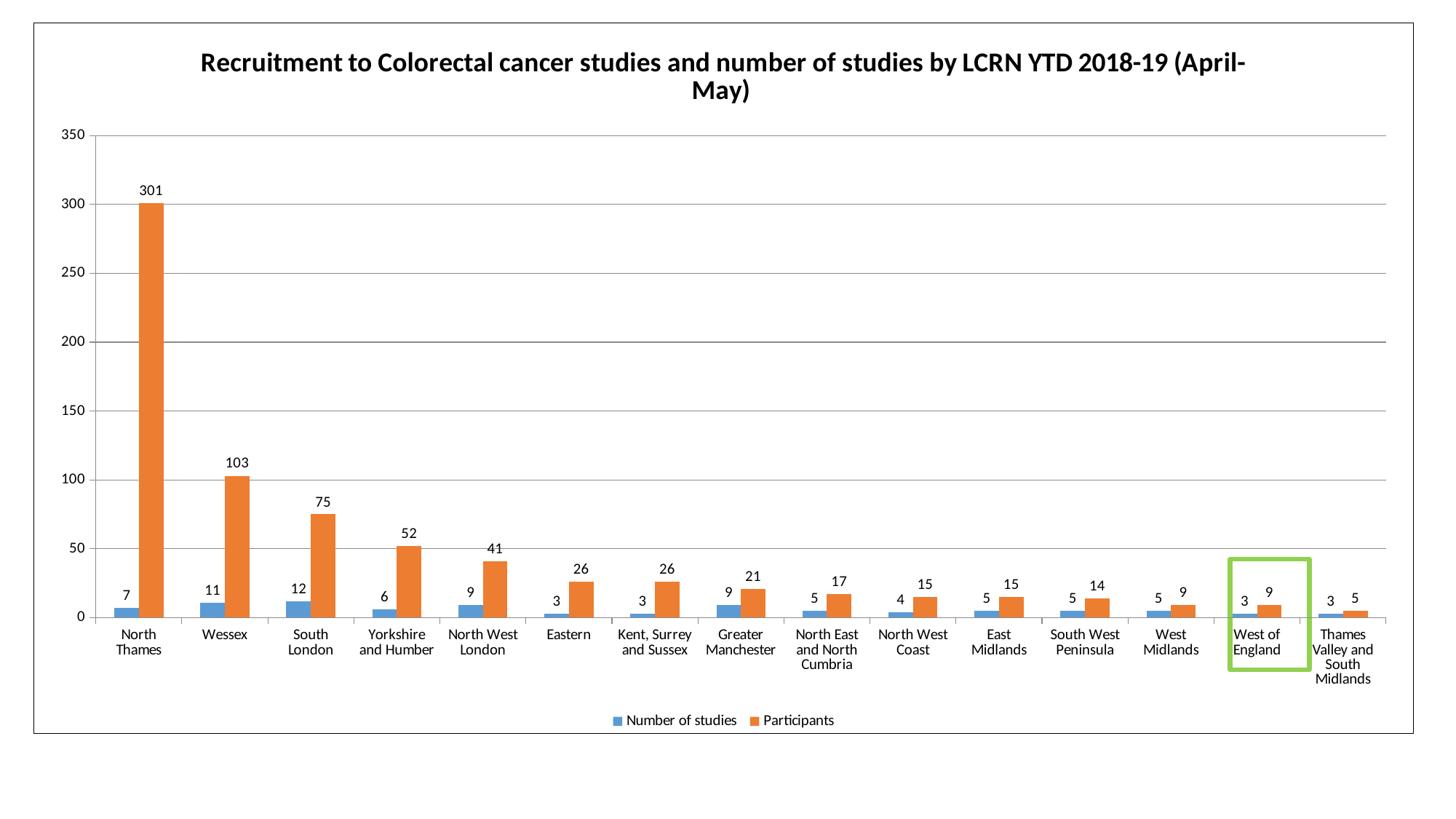
Which LCRN has the lowest number of Participants? Thames Valley and South Midlands Which LCRN is highlighted with a green box? West of England What is the difference in Participants between Wessex and South London? 28 Which LCRN has the highest number of Participants? North Thames What kind of chart is shown on the slide? Bar chart How many LCRNs are shown on the x axis? 15 How many Participants are shown for West of England? 9 How many series does the legend list? 2 Which has more Participants, Yorkshire and Humber or North West London? Yorkshire and Humber Is the Participants value for Wessex greater or less than 100? greater How many Participants are shown for North Thames? 301 What is the Number of studies for South London? 12